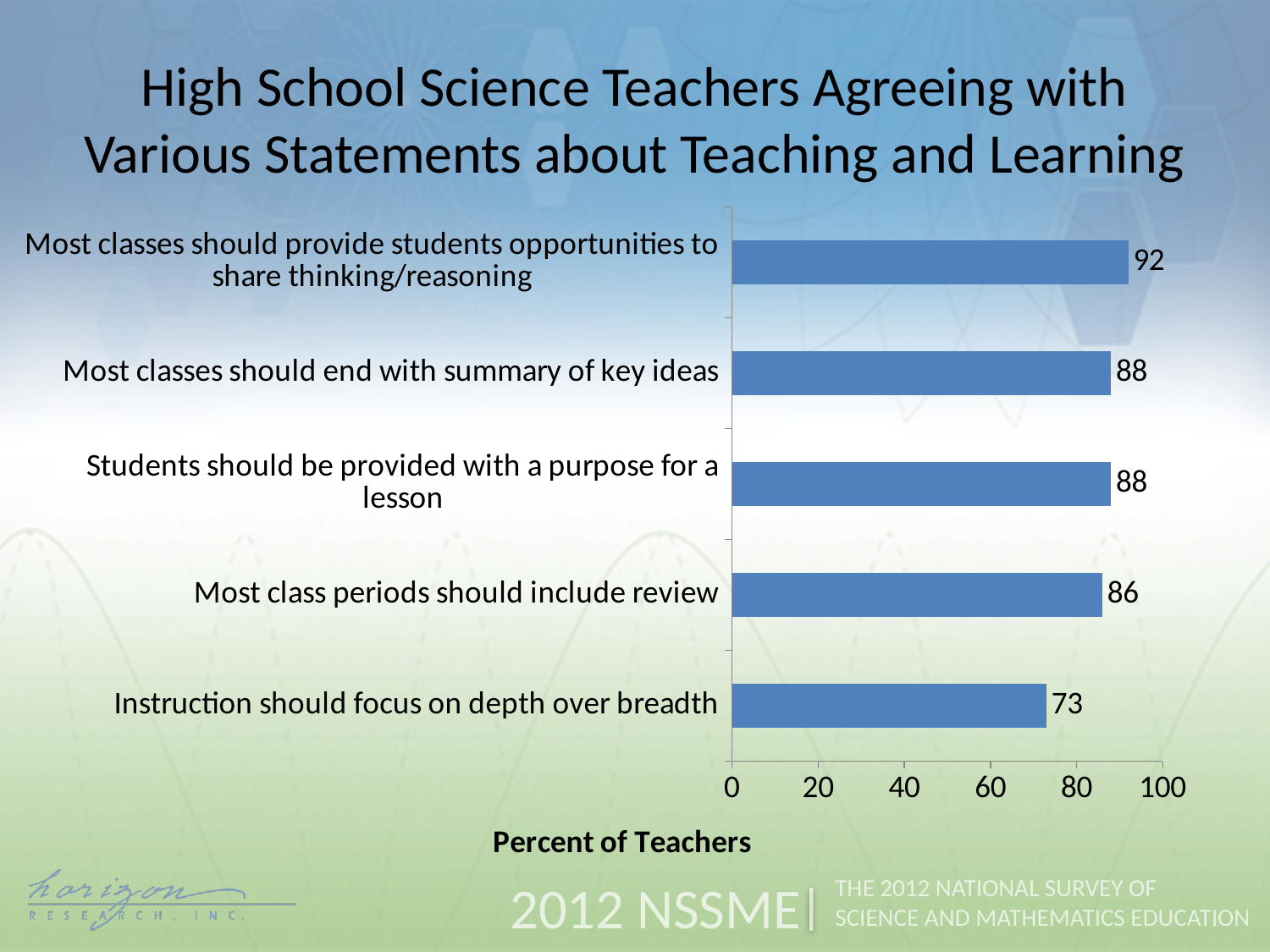
Which statement has the lowest percent of teachers agreeing? Instruction should focus on depth over breadth How many statements are shown in the chart? 5 What kind of chart is shown on the slide? Bar chart Which has a larger percent of teachers agreeing: 'Most class periods should include review' or 'Instruction should focus on depth over breadth'? Most class periods should include review What is the difference in percent of teachers between the highest and lowest statements? 19 What is the label of the horizontal axis? Percent of Teachers What percent of teachers agree that most classes should end with summary of key ideas? 88 What percent of high school science teachers agree that most classes should provide students opportunities to share thinking/reasoning? 92 What percent of teachers agree that instruction should focus on depth over breadth? 73 What is the difference between the percent agreeing that most classes should end with summary of key ideas and the percent agreeing that most class periods should include review? 2 What percent of teachers agree that most class periods should include review? 86 Which statement has the highest percent of teachers agreeing? Most classes should provide students opportunities to share thinking/reasoning